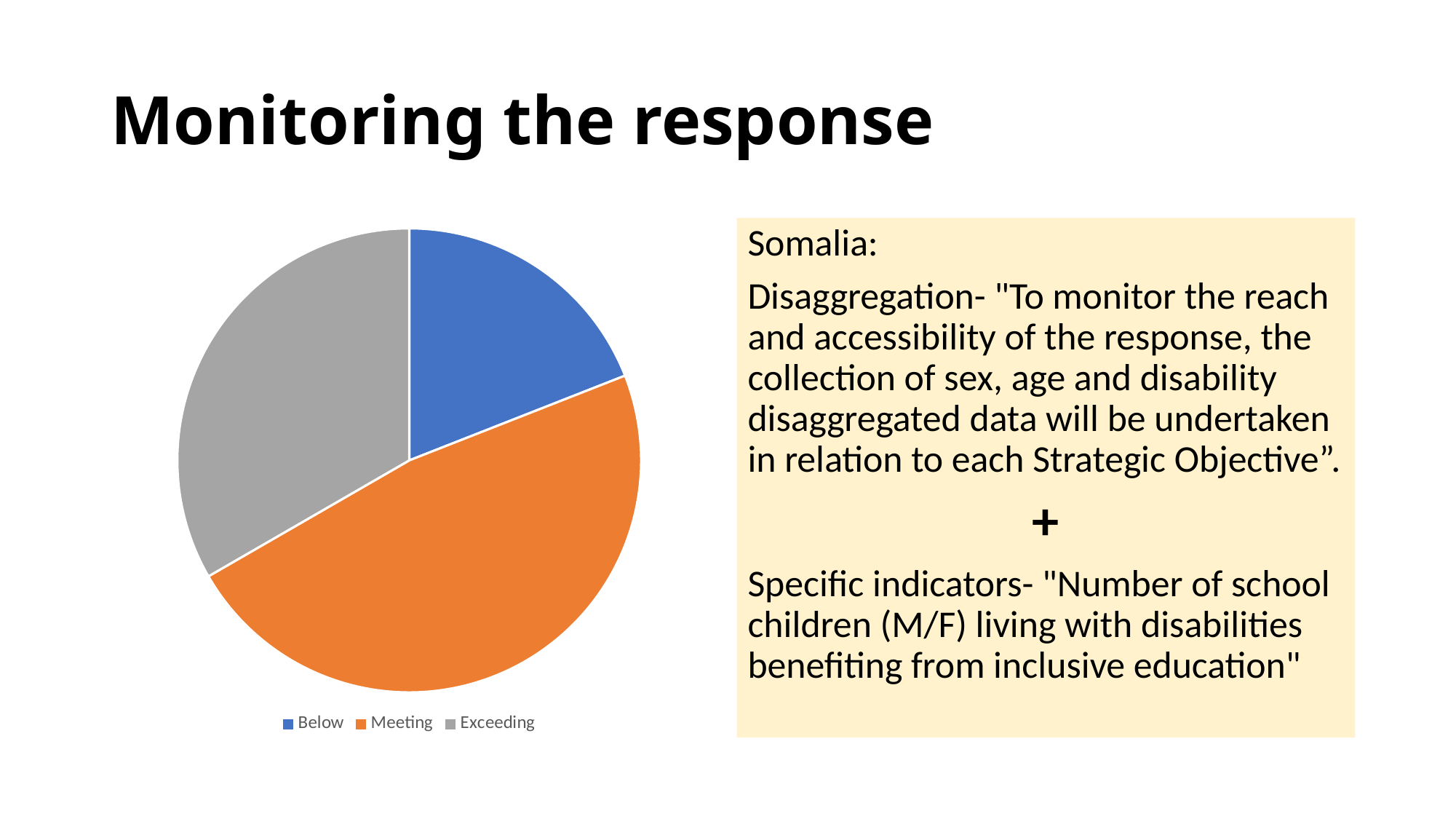
How many slices does the pie chart have? 3 What colour is the Meeting slice in the pie chart? orange Which category has the smallest slice of the pie chart? Below What kind of chart is shown on the slide? pie chart Which slice is larger in the pie chart, Exceeding or Below? Exceeding Which category is shown in grey in the pie chart? Exceeding Which slice is larger in the pie chart, Meeting or Exceeding? Meeting How many entries does the legend of the pie chart list? 3 Which slice is larger in the pie chart, Below or Meeting? Meeting Which category has the largest slice of the pie chart? Meeting